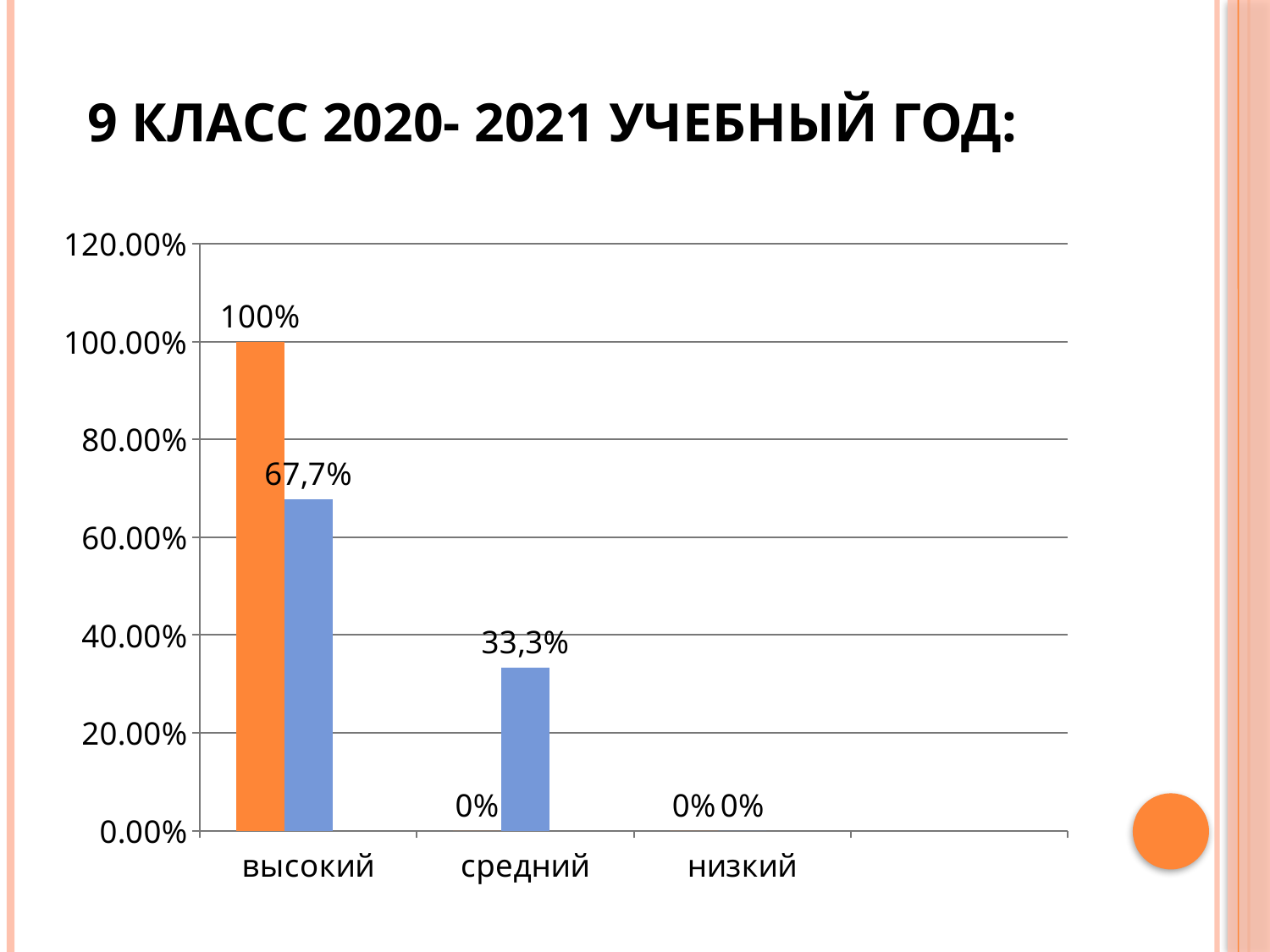
Which category has the highest value for the blue series? высокий Which is larger for the category высокий: the orange bar or the blue bar? the orange bar What is the difference between the orange and blue bars for the category высокий? 32,3% What is the value of the blue bar for the category средний? 33,3% What kind of chart is shown on the slide? bar chart Which category has the highest value for the orange series? высокий What is the value of the blue bar for the category низкий? 0% What is the value of the orange bar for the category средний? 0% How many categories are shown on the x axis? 3 What is the value of the blue bar for the category высокий? 67,7% What is the difference between the blue bars for высокий and средний? 34,4% What is the value of the orange bar for the category высокий? 100%